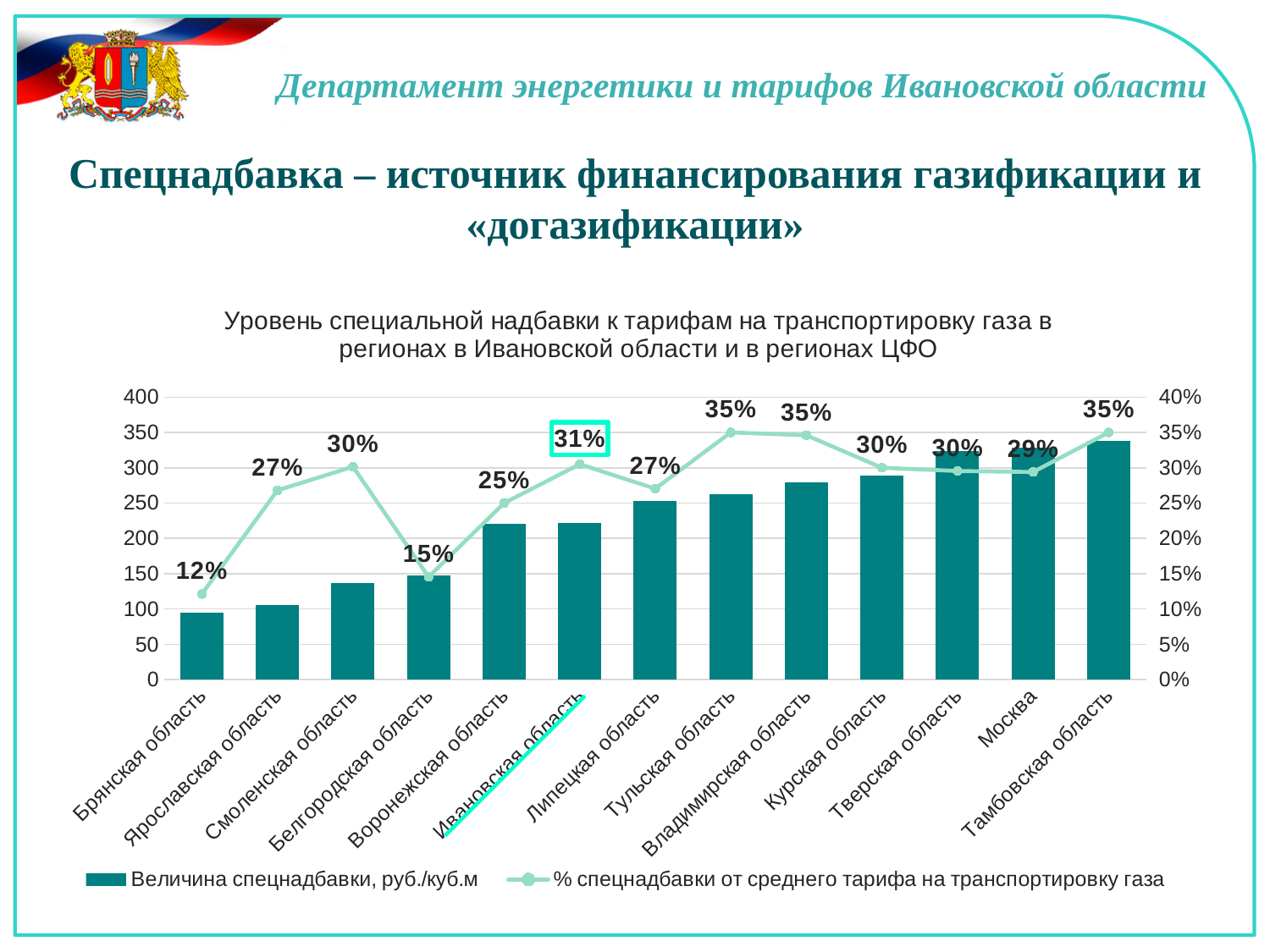
How many regions are shown on the x axis of the chart? 13 What is the value of '% спецнадбавки от среднего тарифа на транспортировку газа' for Брянская область? 12% What is the value of '% спецнадбавки от среднего тарифа на транспортировку газа' for Ивановская область? 31% Which region has the highest bar for 'Величина спецнадбавки, руб./куб.м'? Тамбовская область How many series does the chart legend list? 2 What is the value of '% спецнадбавки от среднего тарифа на транспортировку газа' for Белгородская область? 15% What is the difference in '% спецнадбавки от среднего тарифа' between Ивановская область and Брянская область? 19% What type of chart is shown on the slide? Combined bar and line chart Is the value of 'Величина спецнадбавки, руб./куб.м' for Тамбовская область greater or less than 300? greater Which region has the lowest '% спецнадбавки от среднего тарифа на транспортировку газа'? Брянская область Which region has the lowest bar for 'Величина спецнадбавки, руб./куб.м'? Брянская область Which has a higher '% спецнадбавки от среднего тарифа': Ивановская область or Липецкая область? Ивановская область